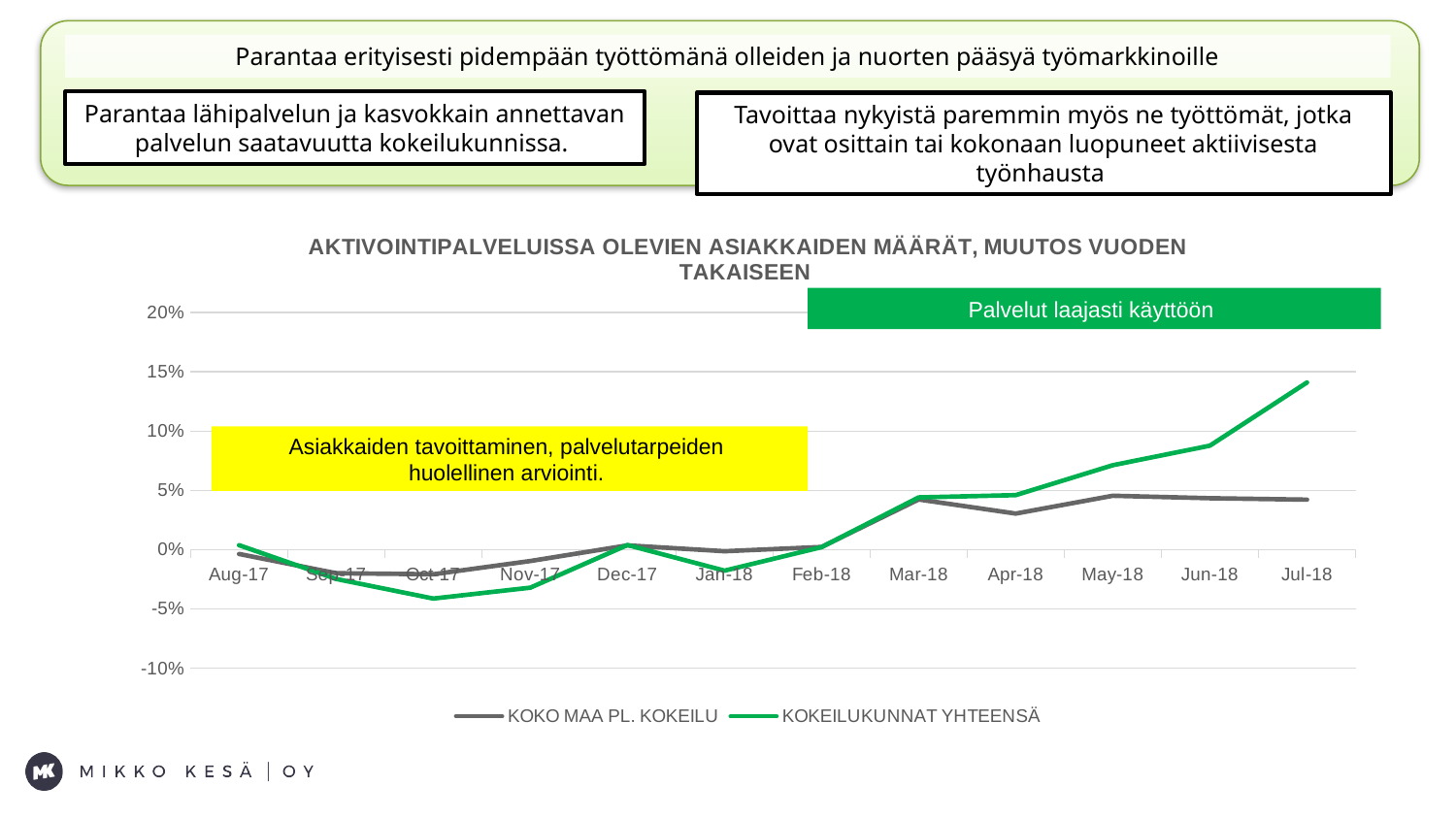
Is the value for KOKO MAA PL. KOKEILU in Jul-18 greater or less than 5%? less What kind of chart is shown on the slide? Line chart Which colour is used for the KOKEILUKUNNAT YHTEENSÄ line? Green How many series does the chart legend list? 2 Does the KOKEILUKUNNAT YHTEENSÄ series rise or fall from Feb-18 to Jul-18? Rise How many months are plotted along the x axis of the chart? 12 What is the title of the chart? AKTIVOINTIPALVELUISSA OLEVIEN ASIAKKAIDEN MÄÄRÄT, MUUTOS VUODEN TAKAISEEN Is the value for KOKEILUKUNNAT YHTEENSÄ in Oct-17 greater or less than 0%? less In which month does the KOKEILUKUNNAT YHTEENSÄ series reach its highest value? Jul-18 Is the value for KOKEILUKUNNAT YHTEENSÄ in Jul-18 greater or less than 10%? greater In Jul-18, which series has the higher value, KOKO MAA PL. KOKEILU or KOKEILUKUNNAT YHTEENSÄ? KOKEILUKUNNAT YHTEENSÄ In which month does the KOKEILUKUNNAT YHTEENSÄ series reach its lowest value? Oct-17